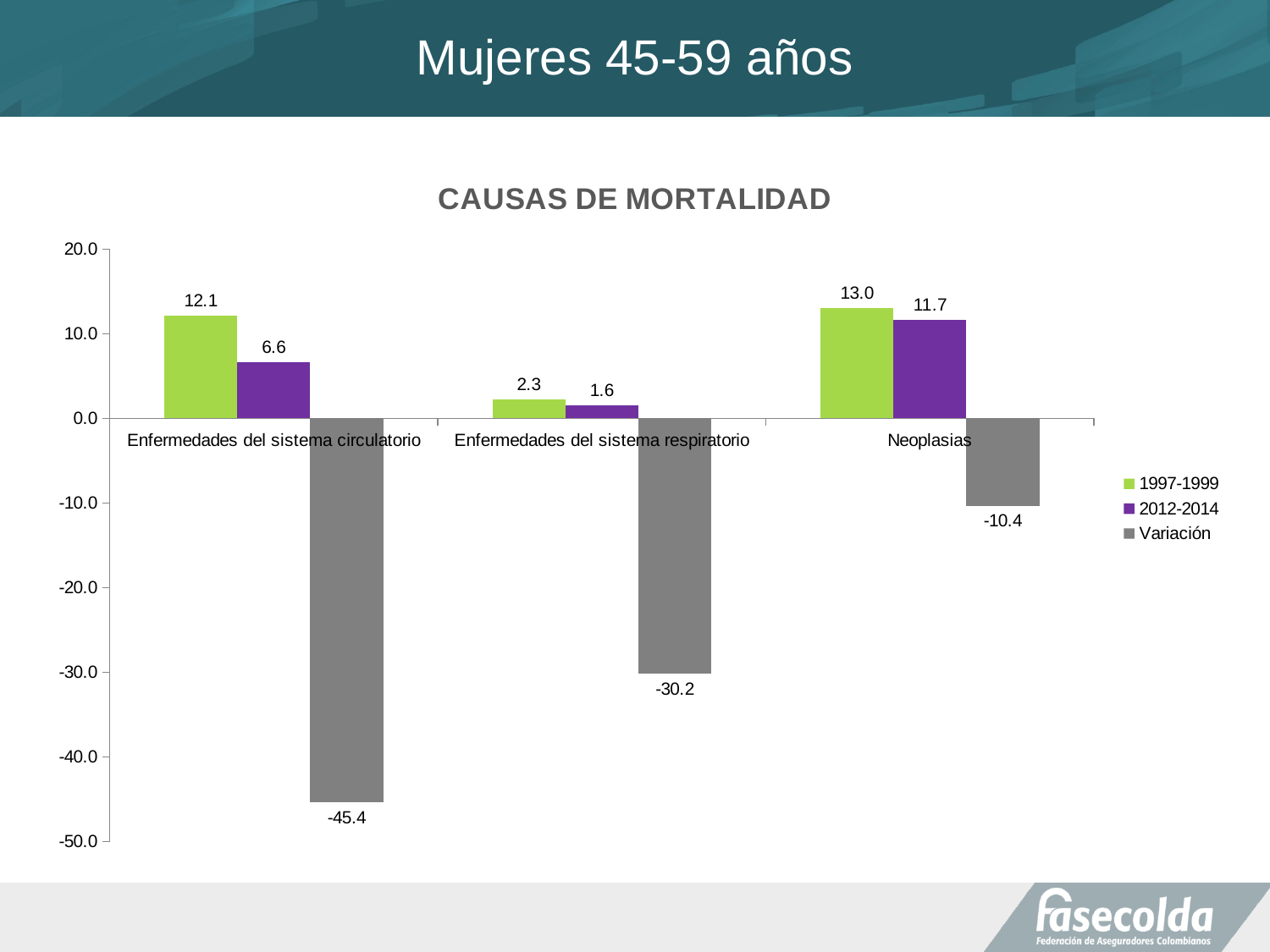
What is the difference between the 1997-1999 and 2012-2014 values for Enfermedades del sistema circulatorio? 5.5 What is the Variación value for Enfermedades del sistema respiratorio? -30.2 How many categories are shown on the x axis? 3 What is the 2012-2014 value for Neoplasias? 11.7 What is the 1997-1999 value for Enfermedades del sistema circulatorio? 12.1 How many series does the legend list? 3 What is the title of the chart? CAUSAS DE MORTALIDAD Is the Variación value for Enfermedades del sistema circulatorio greater or less than -40.0? less Which category has the lowest 2012-2014 value? Enfermedades del sistema respiratorio Which category has the highest 1997-1999 value? Neoplasias What kind of chart is shown? Bar chart Which is larger for Neoplasias: the 1997-1999 value or the 2012-2014 value? 1997-1999